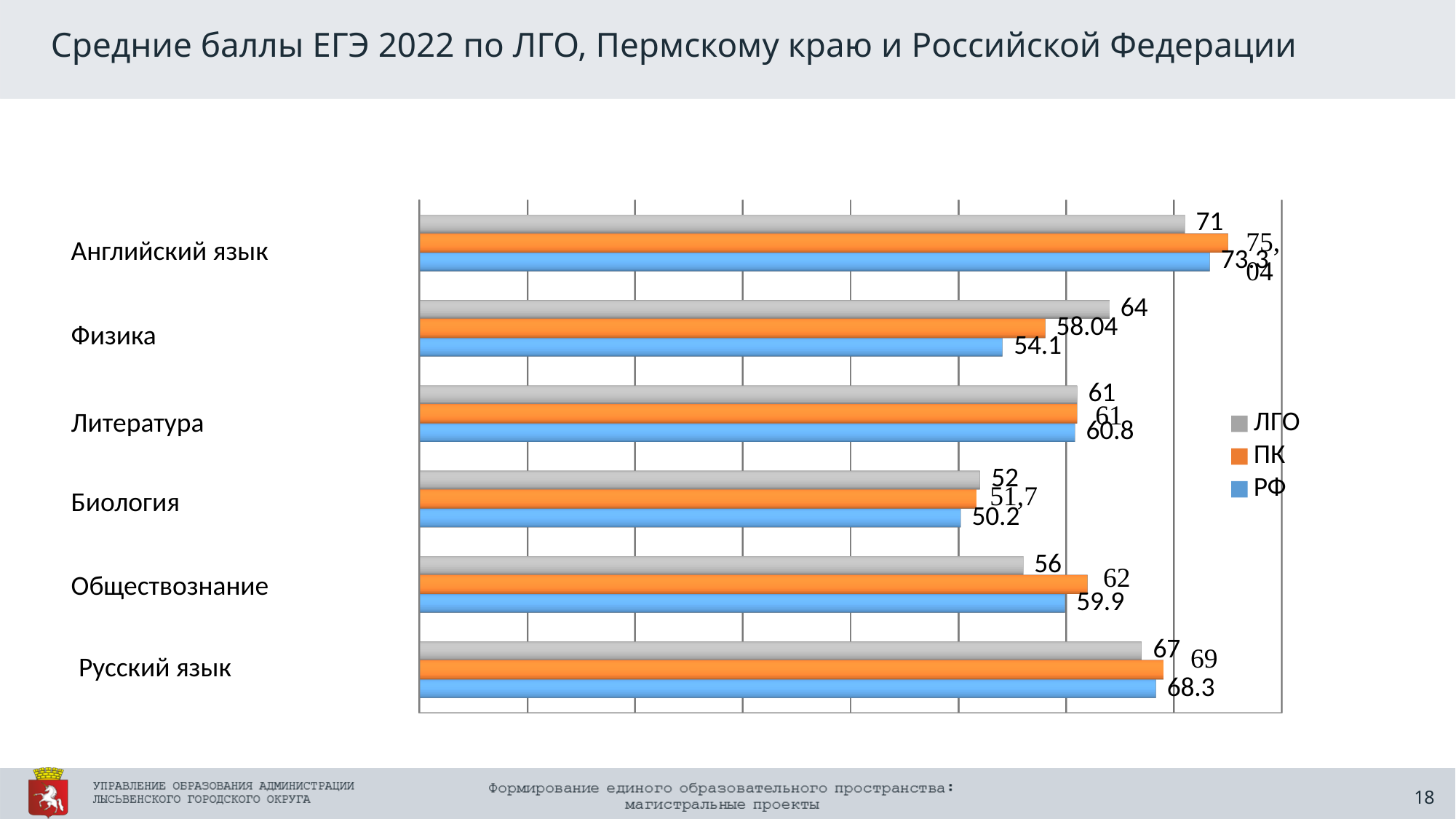
Which series is shown in orange in the legend? ПК What is the РФ value for Биология? 50.2 How many subjects are shown on the chart? 6 What is the РФ value for Русский язык? 68.3 What kind of chart is shown on the slide? Bar chart Which subject has the highest ЛГО value? Английский язык What is the ПК value for Обществознание? 62 How many series does the legend list? 3 What is the difference between the ЛГО and РФ values for Физика? 9.9 What is the ЛГО value for Физика? 64 For Обществознание, which is larger: the ЛГО value or the ПК value? ПК Which subject has the lowest РФ value? Биология